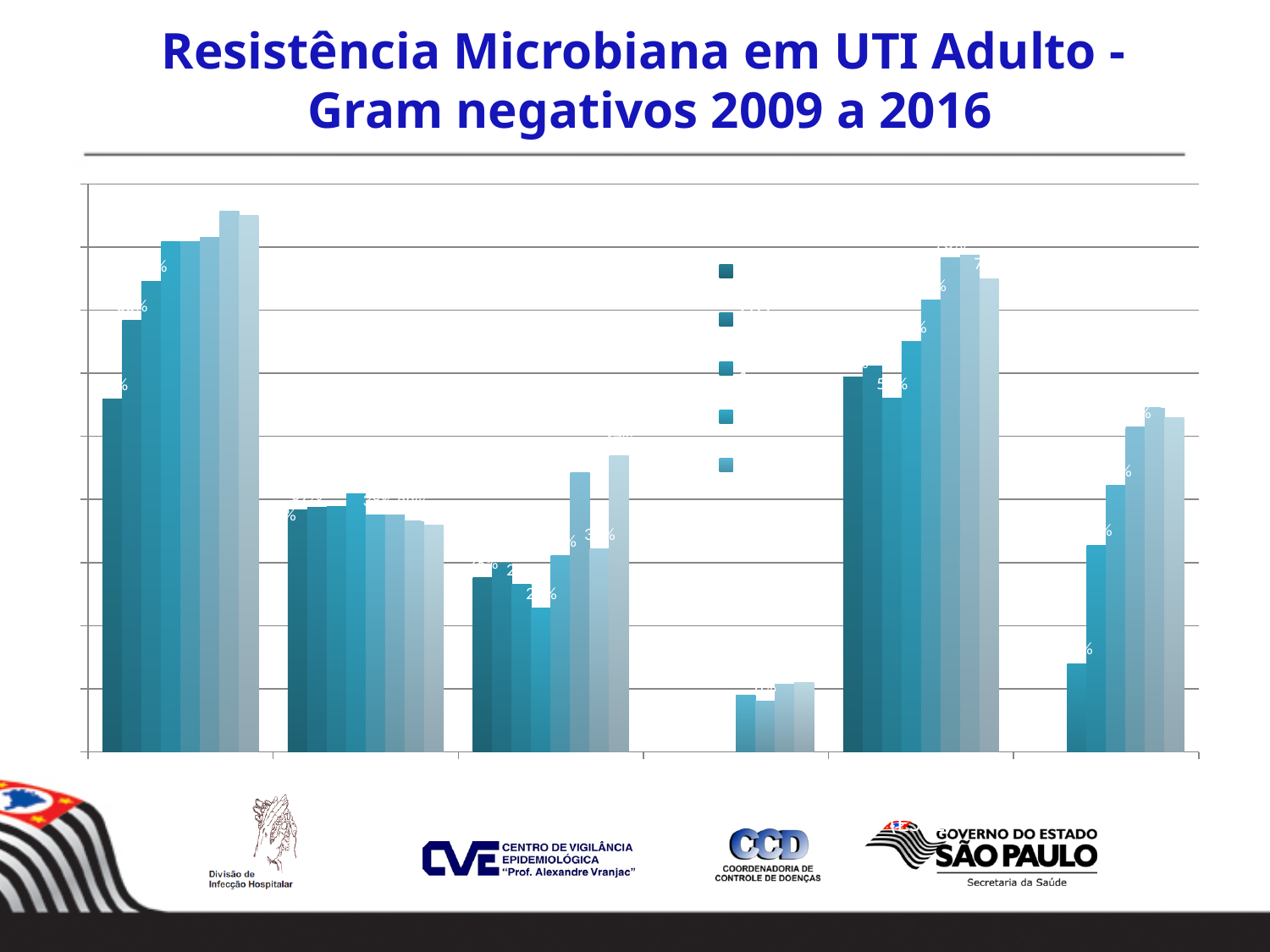
In the first group of bars from the left, do the bars generally rise or fall from left to right? rise Which group has taller bars, the first group from the left or the fourth group from the left? the first group Which group of bars, counted from the left, has the shortest bars in the chart? the fourth group Which group has taller bars, the fifth group from the left or the sixth group from the left? the fifth group What is the title of the slide's chart? Resistência Microbiana em UTI Adulto - Gram negativos 2009 a 2016 What years does the chart title say the data covers? 2009 a 2016 What kind of chart is shown on the slide? bar chart In the sixth (rightmost) group of bars, do the bars generally rise or fall from left to right? rise How many groups of bars are plotted in the chart? 6 Which group of bars, counted from the left, contains the tallest bar in the chart? the first group